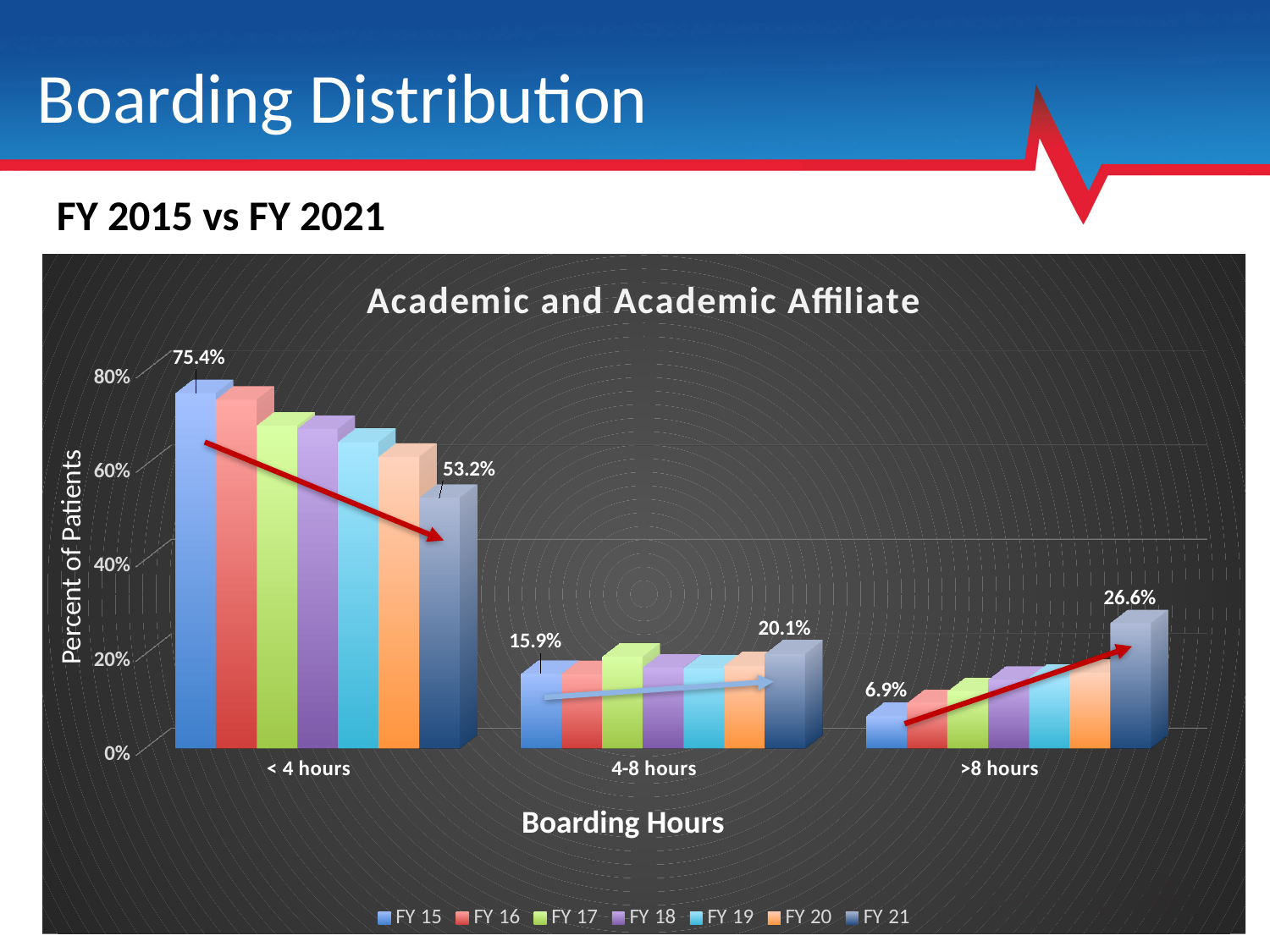
What is the difference between the FY 15 and FY 21 values in the < 4 hours category? 22.2% Which boarding hours category has the highest FY 15 value? < 4 hours Which boarding hours category has the lowest FY 15 value? >8 hours How many series does the legend list? 7 What is the value for FY 21 in the >8 hours category? 26.6% What kind of chart is shown on the slide? Bar chart What is the value for FY 21 in the < 4 hours category? 53.2% What is the value for FY 15 in the 4-8 hours category? 15.9% Is the value for FY 17 in the < 4 hours category greater or less than 60%? greater What is the value for FY 15 in the < 4 hours category? 75.4% What is the difference between the FY 21 and FY 15 values in the >8 hours category? 19.7% Which is larger in the 4-8 hours category, the FY 15 value or the FY 21 value? FY 21